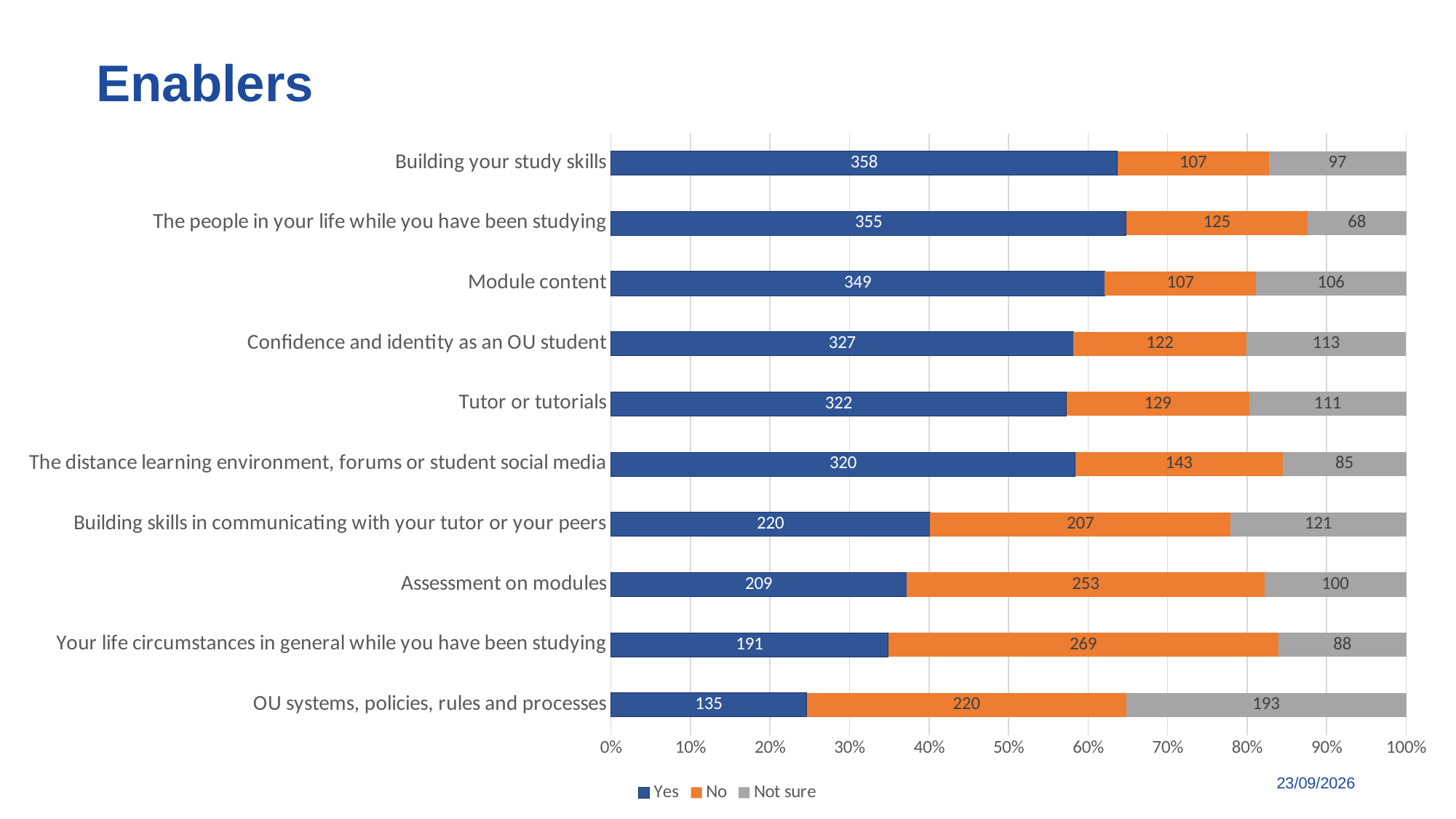
Which category has the lowest 'Yes' value? OU systems, policies, rules and processes What is the total of the three values for Building skills in communicating with your tutor or your peers? 548 How many categories are shown on the chart? 10 What kind of chart is shown on the slide? Stacked bar chart How many series does the legend list? 3 Is the 'Yes' share of the bar for OU systems, policies, rules and processes greater or less than 30%? less What is the 'Yes' value for Module content? 349 Which is larger: the 'Not sure' value for Confidence and identity as an OU student or for The people in your life while you have been studying? Confidence and identity as an OU student What is the difference between the 'No' values for Your life circumstances in general while you have been studying and Tutor or tutorials? 140 Which category has the highest 'Yes' value? Building your study skills What is the 'No' value for Assessment on modules? 253 What is the 'Not sure' value for OU systems, policies, rules and processes? 193